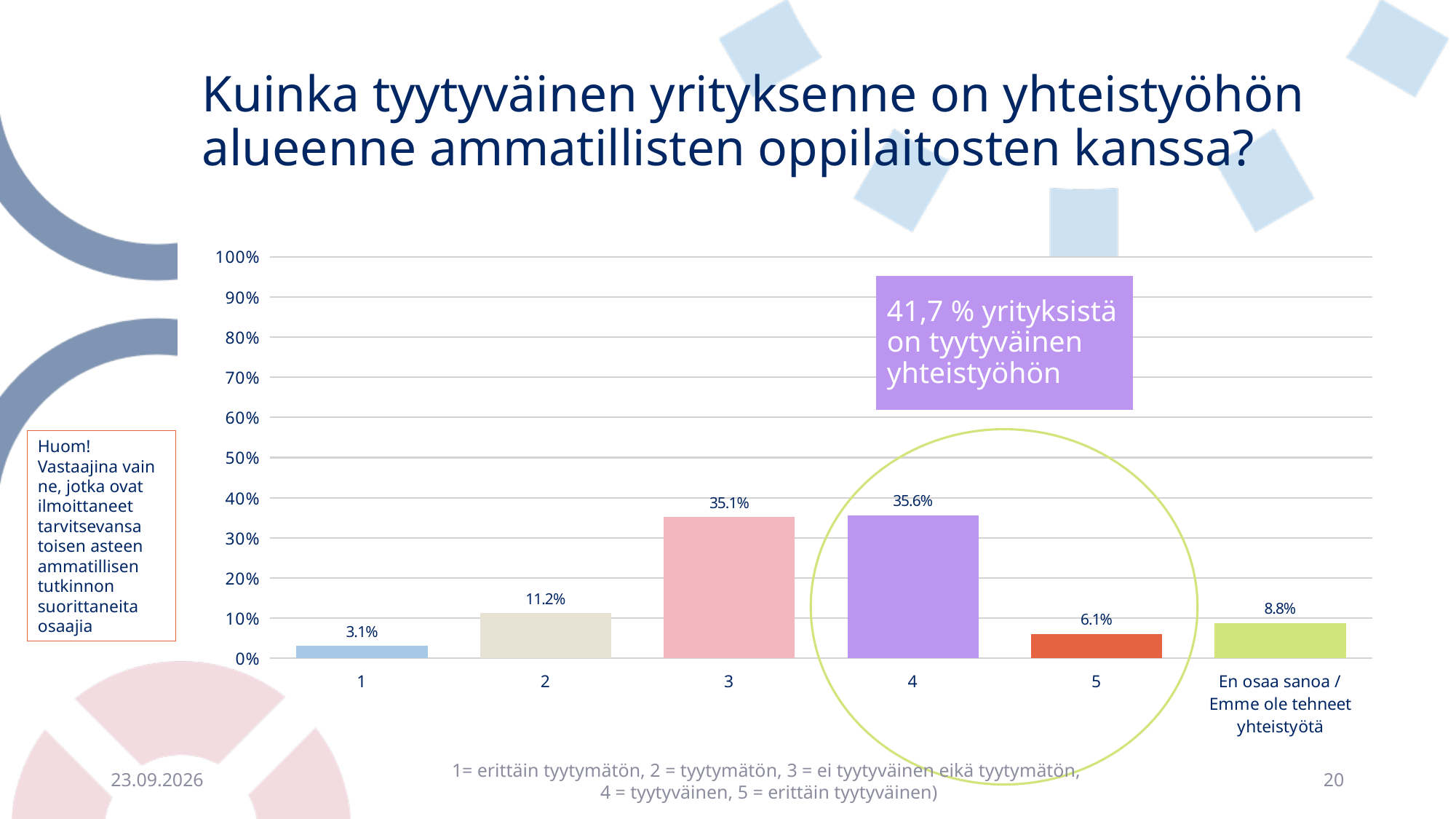
What is the total of the values for categories 4 and 5? 41.7% What kind of chart is shown on the slide? bar chart What is the difference between the values for category 3 and category 2? 23.9% What is the value for category 2? 11.2% What is the value for category 1? 3.1% Which category has the lowest value? 1 How many categories are shown on the x axis? 6 Which category has the highest value? 4 What is the value for the category 'En osaa sanoa / Emme ole tehneet yhteistyötä'? 8.8% Which is larger, the value for category 5 or the value for 'En osaa sanoa / Emme ole tehneet yhteistyötä'? En osaa sanoa / Emme ole tehneet yhteistyötä What is the value for category 4? 35.6% Is the value for category 3 greater or less than 30%? greater